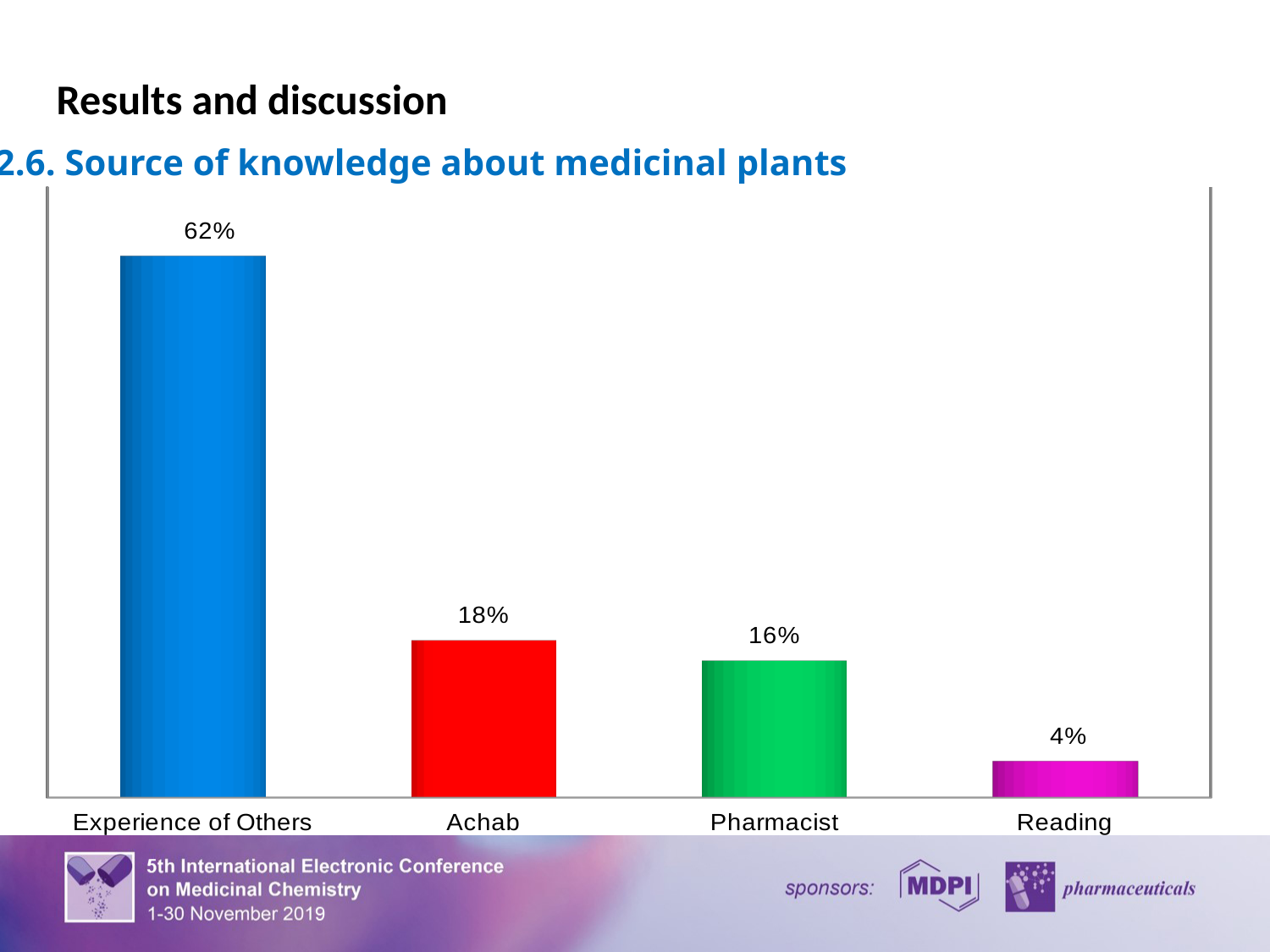
Which source of knowledge has the highest percentage? Experience of Others Which is larger, the value for Achab or the value for Pharmacist? Achab What is the difference between the percentages for Pharmacist and Reading? 12% What percentage is shown for Achab? 18% How many sources of knowledge are shown in the chart? 4 What is the difference between the percentages for Experience of Others and Achab? 44% What kind of chart is shown on the slide? Bar chart What percentage is shown for Reading? 4% What percentage is shown for Pharmacist? 16% Which source of knowledge has the lowest percentage? Reading What percentage is shown for Experience of Others? 62% What colour is the bar for Pharmacist? Green